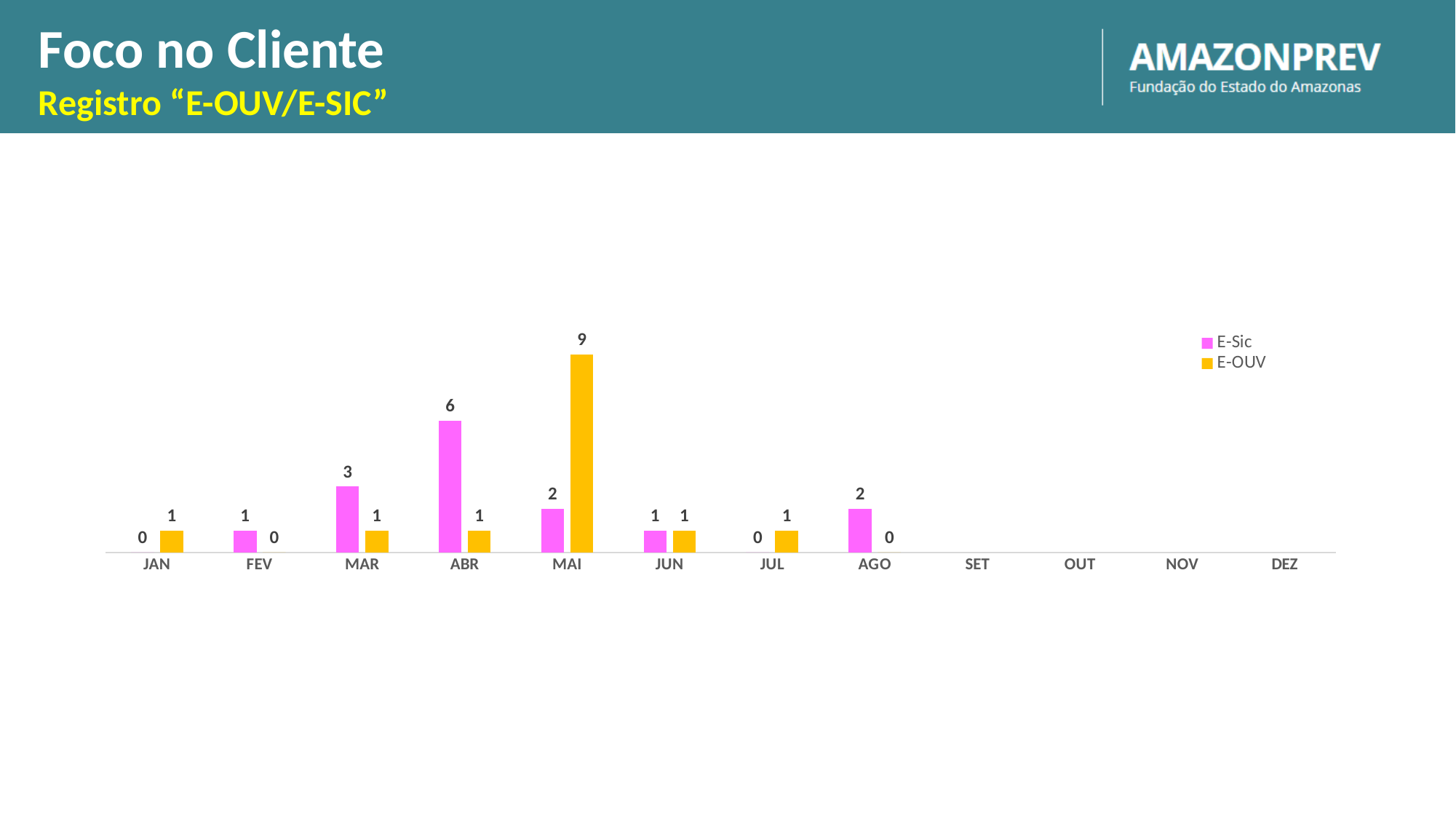
Which is larger in ABR, the E-Sic value or the E-OUV value? E-Sic What colour represents the E-OUV series? Yellow What is the E-OUV value for JUL? 1 What kind of chart is shown on the slide? Bar chart What is the E-Sic value for ABR? 6 What is the E-OUV value for MAI? 9 How many series does the legend list? 2 What is the E-Sic value for MAR? 3 What is the difference between the E-OUV and E-Sic values in MAI? 7 In which month is the E-OUV value highest? MAI In which month is the E-Sic value highest? ABR How many month categories are shown on the x axis? 12